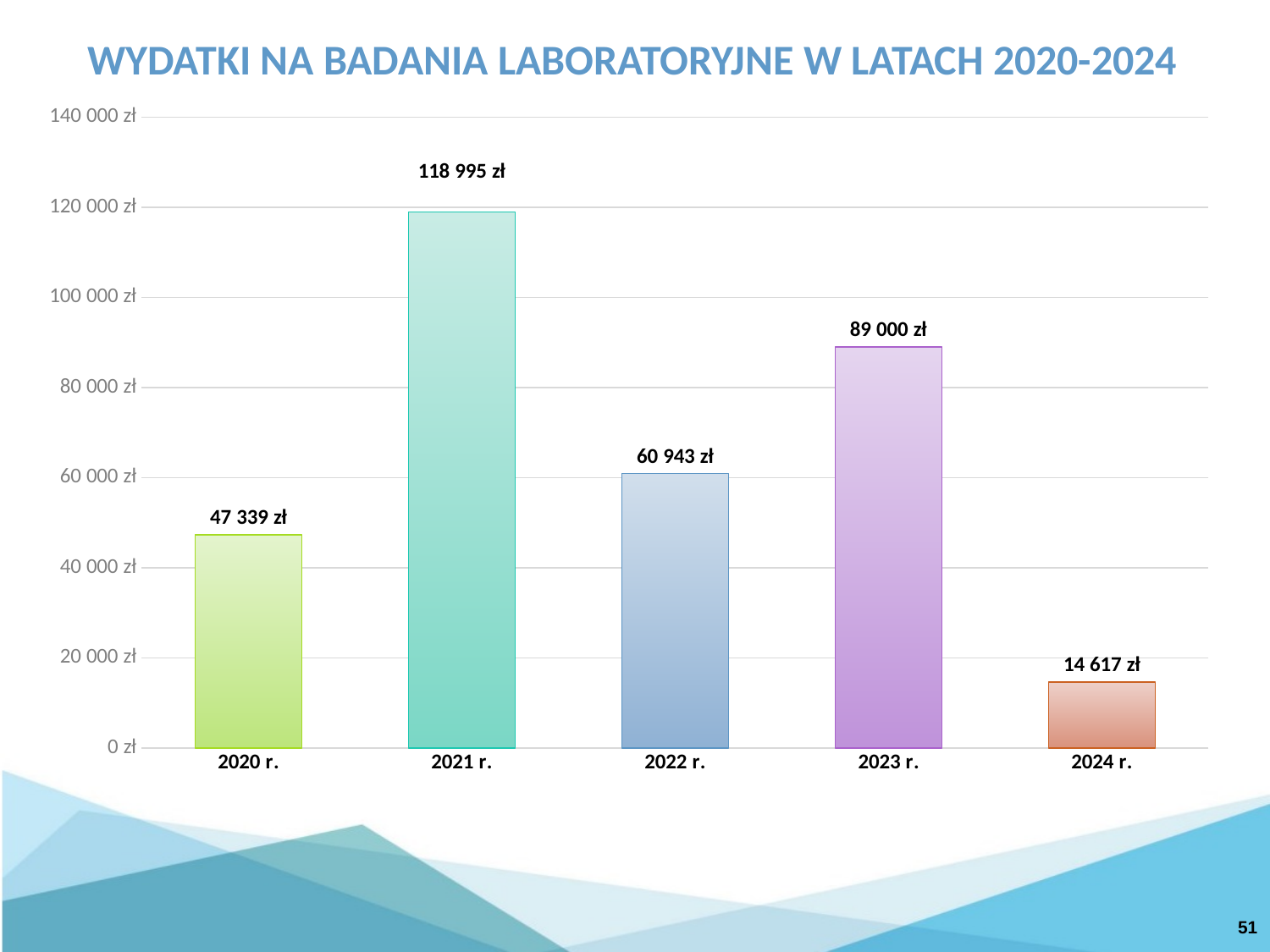
What kind of chart is shown on the slide? bar chart What is the value for 2021 r.? 118 995 zł Which is larger, the value for 2020 r. or the value for 2022 r.? 2022 r. Which year has the lowest expenditure? 2024 r. Which year has the highest expenditure? 2021 r. Is the value for 2023 r. greater or less than 80 000 zł? greater What is the difference between the values for 2022 r. and 2020 r.? 13 604 zł How many years are shown on the x axis? 5 What is the difference between the values for 2021 r. and 2023 r.? 29 995 zł What is the title of the chart? WYDATKI NA BADANIA LABORATORYJNE W LATACH 2020-2024 What is the value for 2022 r.? 60 943 zł What is the value for 2024 r.? 14 617 zł